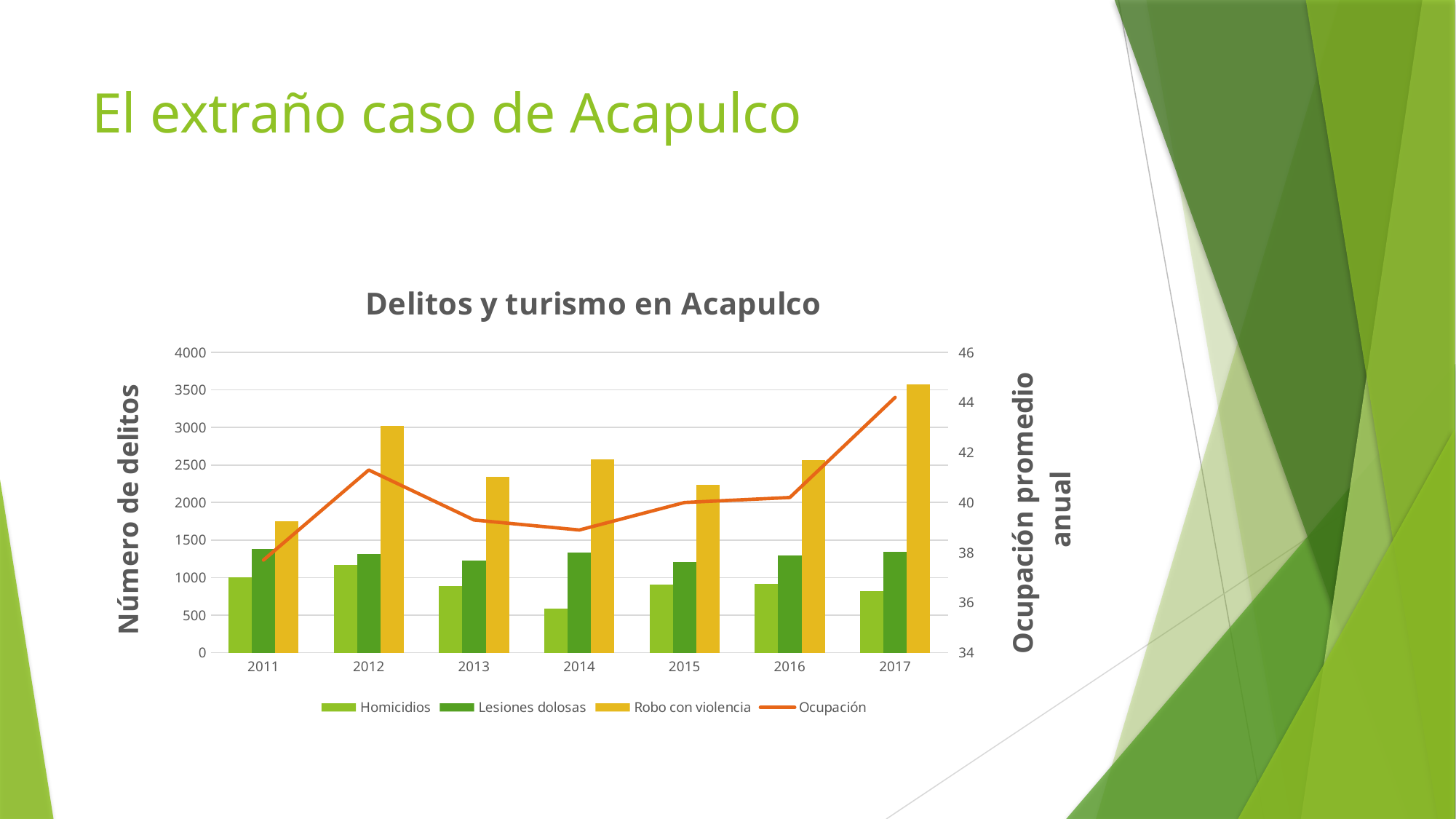
What kind of chart is this? Bar chart combined with a line Is the value for Homicidios in 2014 greater or less than 1000? less Does the Ocupación line rise or fall from 2014 to 2017? rise Is the value for Robo con violencia in 2017 greater or less than 3000? greater In which year is the Robo con violencia bar highest? 2017 In which year is the Ocupación line at its lowest? 2011 How many series does the legend list? 4 How many years are shown on the x axis? 7 What is the title of the chart? Delitos y turismo en Acapulco Is the Ocupación value in 2014 greater or less than 40? less Which is larger, Robo con violencia in 2012 or in 2013? 2012 In which year is the Homicidios bar lowest? 2014